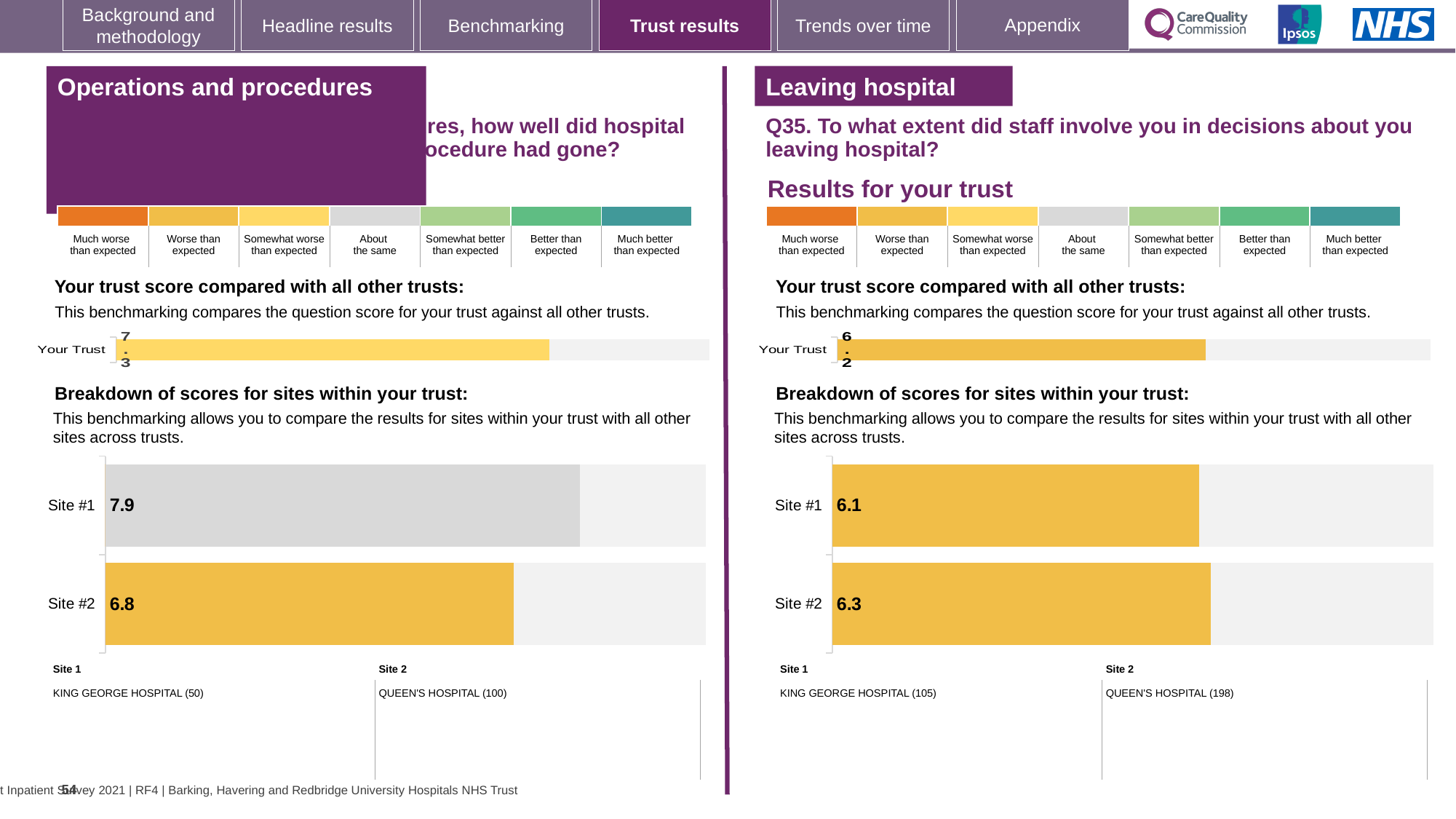
In the Operations and procedures section, what is the Your Trust score shown in the trust score chart? 7.3 What type of chart is used for the breakdown of scores for sites in the Operations and procedures section? Bar chart In the Operations and procedures breakdown of scores for sites chart, what is the difference between the Site #1 and Site #2 scores? 1.1 In the Leaving hospital breakdown of scores for sites chart, what is the difference between the Site #2 and Site #1 scores? 0.2 In the Leaving hospital section, what is the Your Trust score shown in the trust score chart? 6.2 In the Operations and procedures section, what is the score for Site #2 in the breakdown of scores for sites chart? 6.8 In the Leaving hospital breakdown of scores for sites chart, which site has the lower score? Site #1 In the Leaving hospital section, what is the score for Site #2 in the breakdown of scores for sites chart? 6.3 In the Operations and procedures breakdown of scores for sites chart, which site has the higher score? Site #1 In the Operations and procedures section, what is the score for Site #1 in the breakdown of scores for sites chart? 7.9 How many sites are shown in the Leaving hospital breakdown of scores for sites chart? 2 In the Leaving hospital section, what is the score for Site #1 in the breakdown of scores for sites chart? 6.1